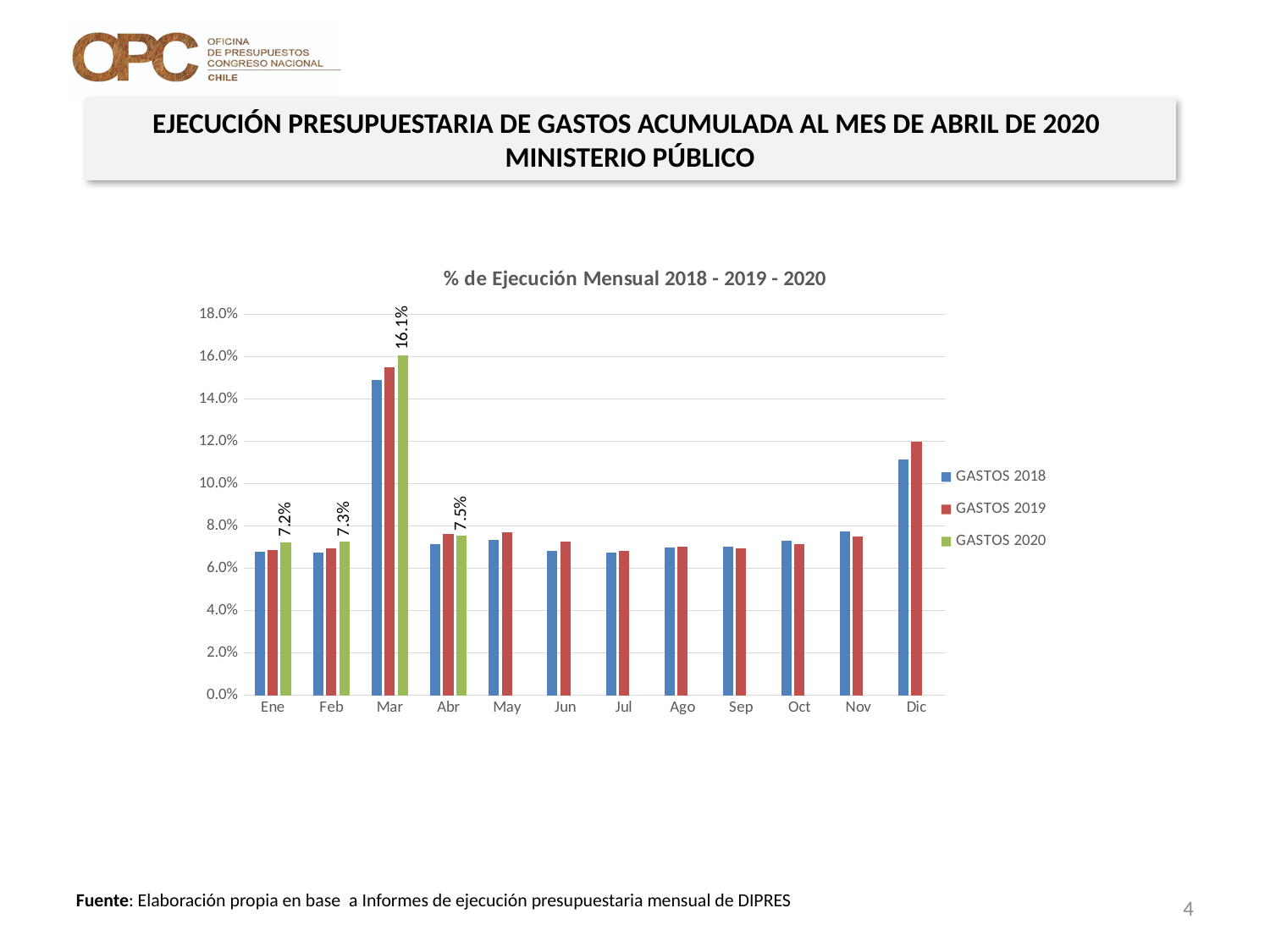
What is the value for GASTOS 2020 in Ene? 7.2% Which month has the lowest value for GASTOS 2020? Ene How many series does the legend list? 3 Is the value for GASTOS 2018 in Mar greater or less than 14.0%? greater What is the value for GASTOS 2020 in Abr? 7.5% What is the title of the chart? % de Ejecución Mensual 2018 - 2019 - 2020 What is the difference between the GASTOS 2020 values for Mar and Abr? 8.6% How many months are shown on the x axis? 12 Which is larger in Dic: GASTOS 2018 or GASTOS 2019? GASTOS 2019 What kind of chart is shown on the slide? Bar chart What is the value for GASTOS 2020 in Mar? 16.1% Which month has the highest value for GASTOS 2020? Mar